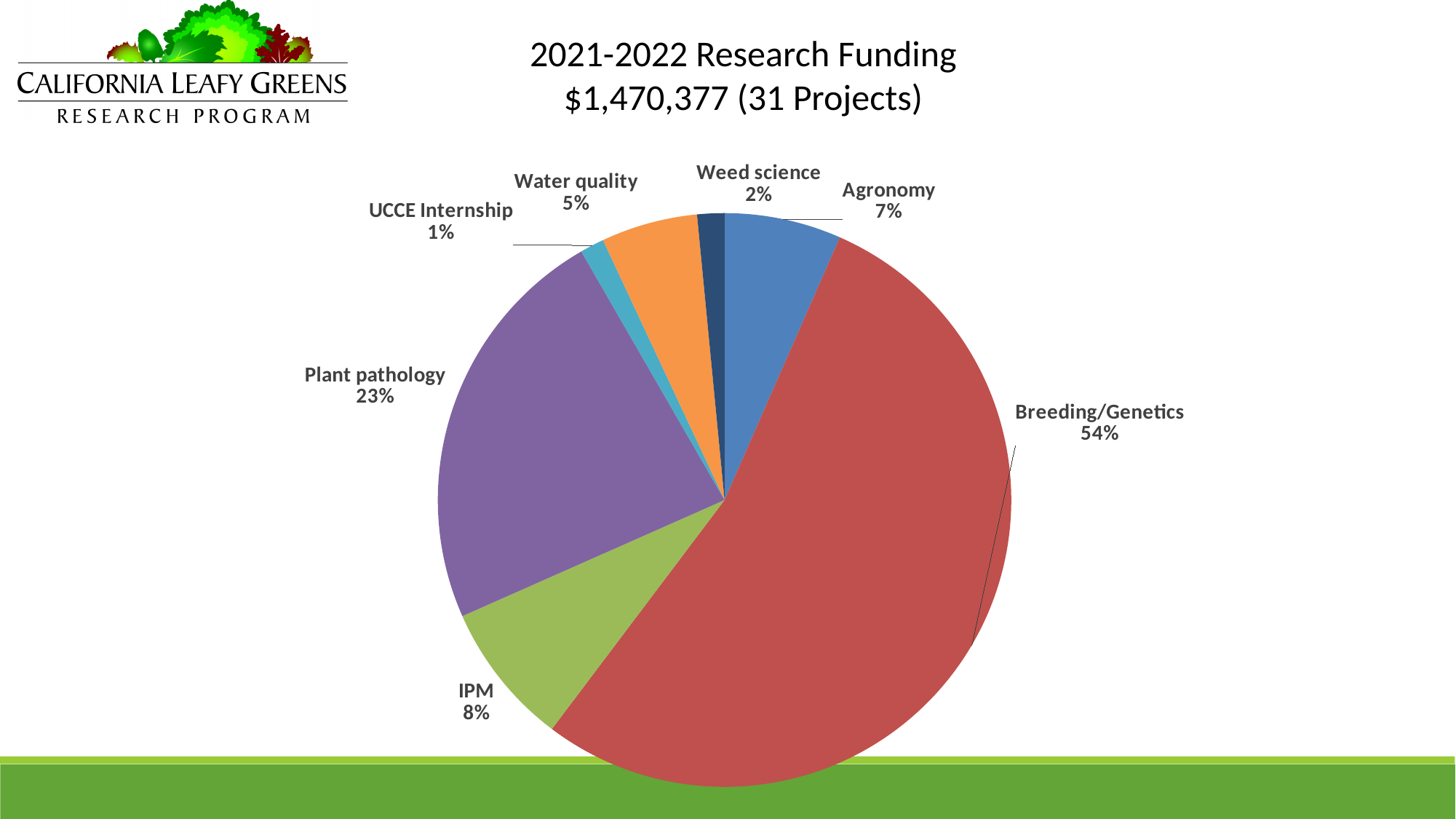
What percentage is shown for IPM? 8% What is the combined percentage of Weed science and Agronomy? 9% What is the title of the chart? 2021-2022 Research Funding $1,470,377 (31 Projects) What kind of chart is shown on the slide? Pie chart Which category has the smallest slice of the pie? UCCE Internship How many categories are shown in the pie chart? 7 What percentage is shown for Plant pathology? 23% Which category has the largest slice of the pie? Breeding/Genetics Which is larger, the share for Agronomy or the share for IPM? IPM What share of the pie does Breeding/Genetics account for? 54% What percentage is shown for Water quality? 5% What is the difference in percentage points between Breeding/Genetics and Plant pathology? 31